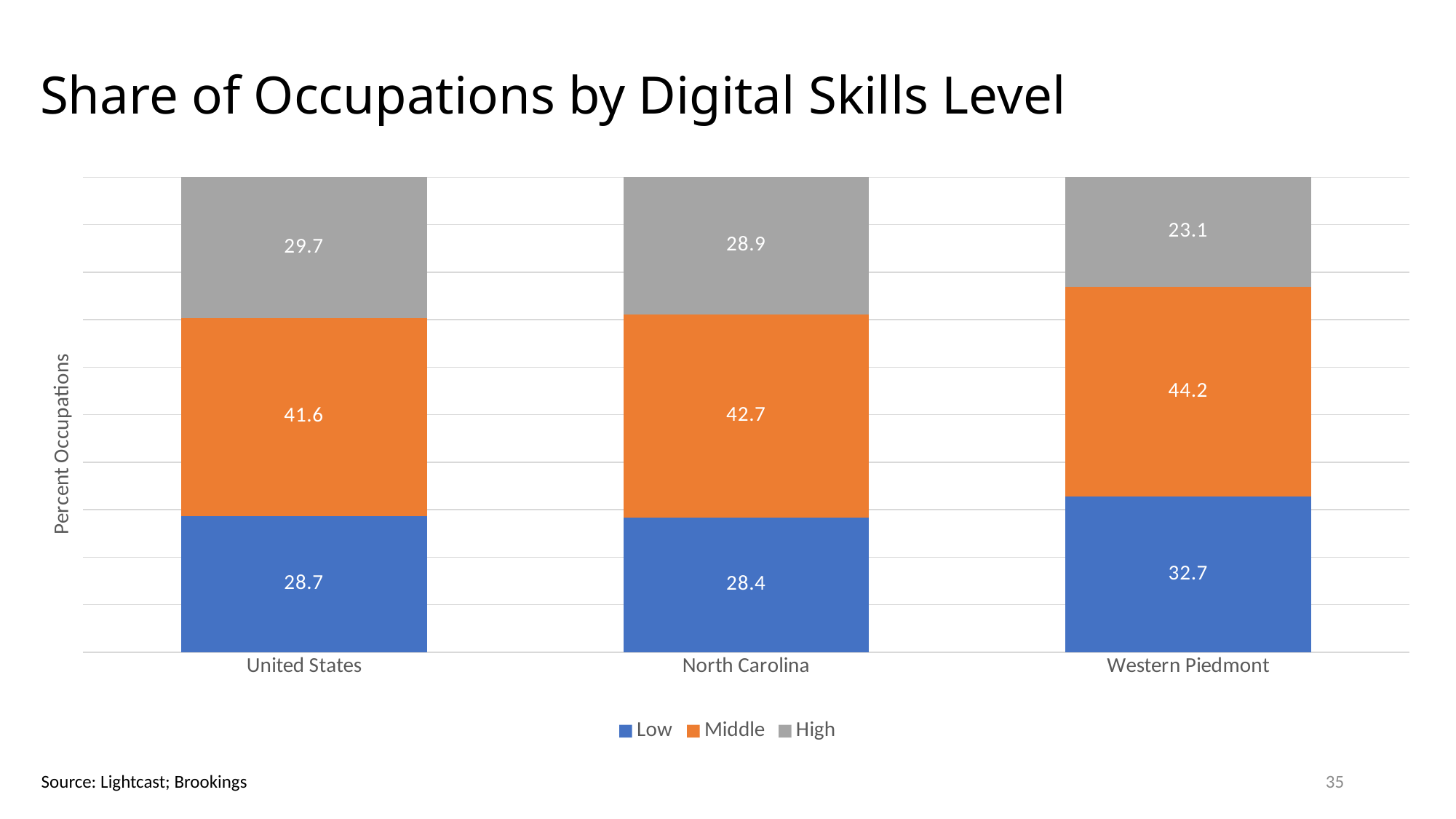
Which region has the lowest High value? Western Piedmont Which is larger, the Low value for the United States or the Low value for Western Piedmont? Western Piedmont What kind of chart is shown? Stacked bar chart What is the Low value for Western Piedmont? 32.7 What is the difference between the High values for the United States and Western Piedmont? 6.6 What is the High value for the United States? 29.7 How many regions are shown on the x axis? 3 What is the title of the chart? Share of Occupations by Digital Skills Level How many series does the legend list? 3 What is the total of the stacked bar for North Carolina? 100.0 What is the Middle value for North Carolina? 42.7 Which region has the highest Middle value? Western Piedmont